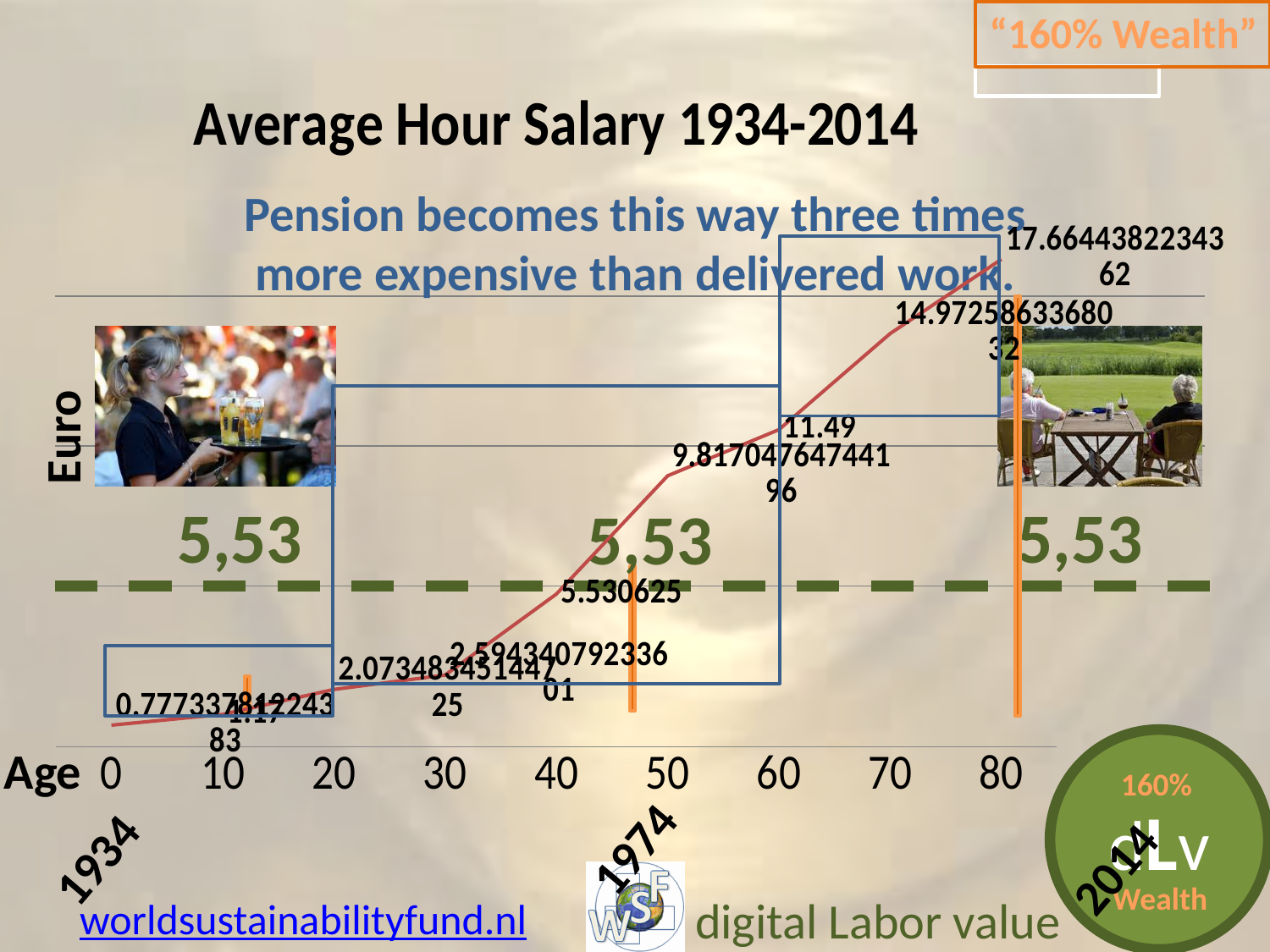
At which age is the average hour salary lowest? 0 What is the difference between the value at age 60 and the value at age 40? 5.959375 Is the value at age 20 greater or less than 5? less What is the label on the y axis of the chart? Euro What kind of chart is shown on the slide? line chart What is the value shown at age 60? 11.49 Is the value at age 80 greater or less than 15? greater At which age is the average hour salary highest? 80 Which is larger, the value at age 60 or the value at age 40? age 60 Do the values rise or fall as age increases along the x axis? rise What is the title of the chart? Average Hour Salary 1934-2014 What is the value shown at age 40? 5.530625